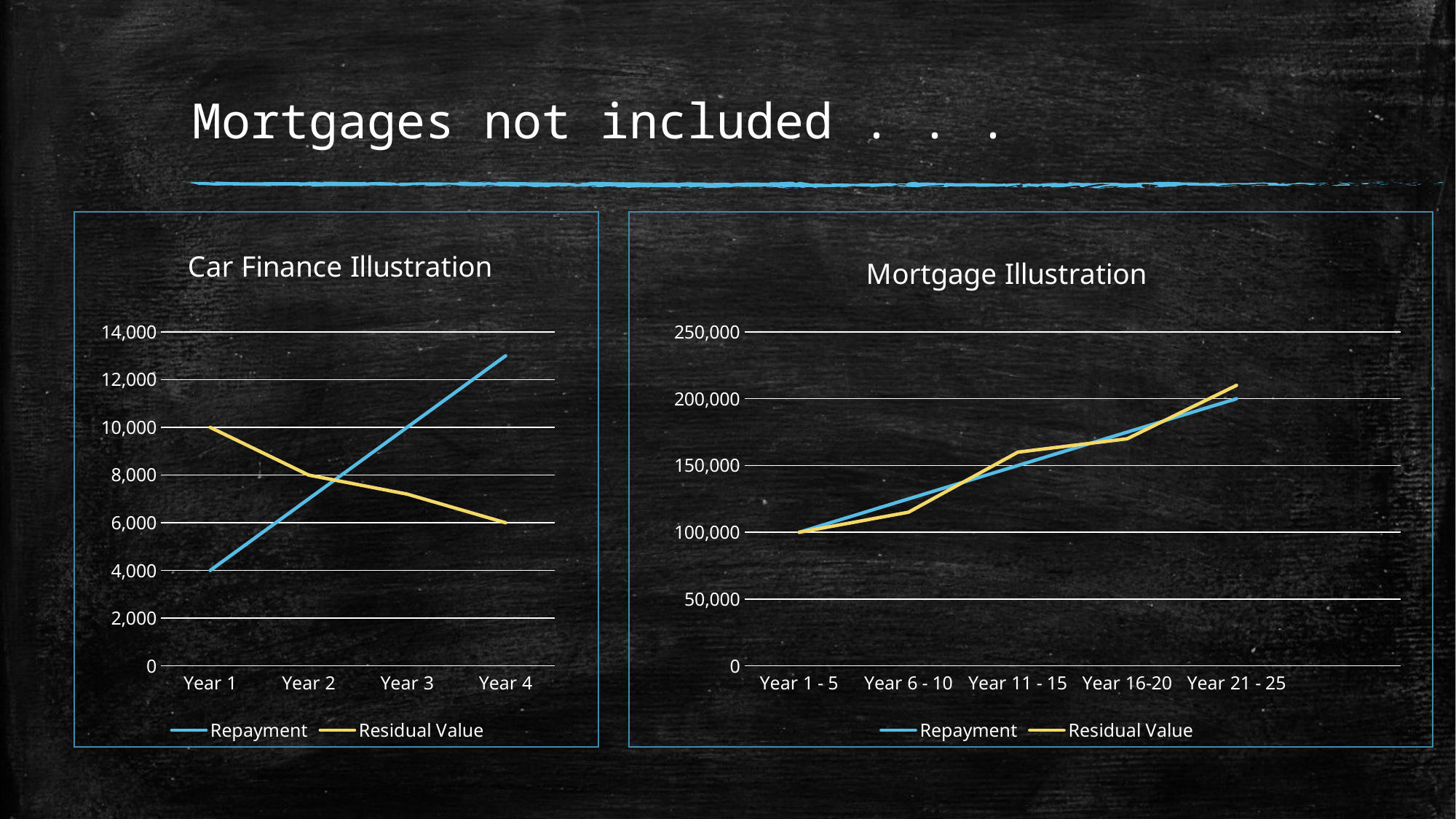
In the Mortgage Illustration chart, is the Residual Value for Year 6 - 10 greater or less than 150,000? less In the Mortgage Illustration chart, what is the Repayment value for Year 1 - 5? 100,000 In the Car Finance Illustration chart, which series is higher at Year 4, Repayment or Residual Value? Repayment In the Car Finance Illustration chart, what is the Repayment value for Year 1? 4,000 How many series does the legend of the Mortgage Illustration chart list? 2 In the Car Finance Illustration chart, what is the Residual Value for Year 1? 10,000 In the Mortgage Illustration chart, what is the Repayment value for Year 21 - 25? 200,000 How many categories are shown on the x axis of the Car Finance Illustration chart? 4 In the Car Finance Illustration chart, does the Residual Value line rise or fall from Year 1 to Year 4? fall What kind of chart is the Mortgage Illustration? line chart In the Car Finance Illustration chart, is the Repayment value for Year 4 greater or less than 12,000? greater In the Car Finance Illustration chart, what is the Residual Value for Year 4? 6,000